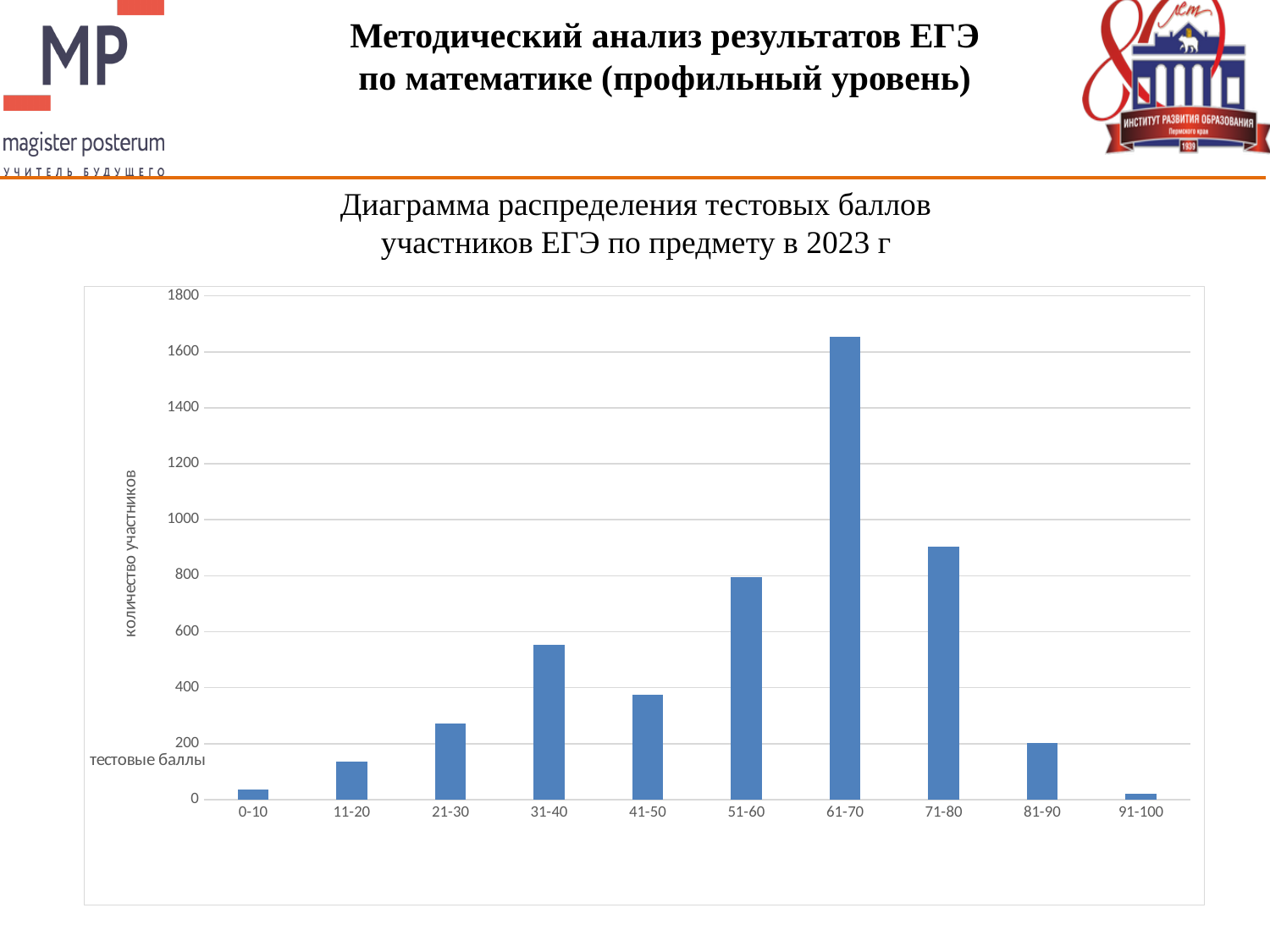
Which has more participants, 31-40 or 41-50? 31-40 Is the value for 71-80 greater or less than 1000? less Which score range has the highest number of participants? 61-70 What kind of chart is shown on the slide? bar chart Is the value for 61-70 greater or less than 1600? greater Which score range has the lowest number of participants? 91-100 Is the value for 41-50 greater or less than 400? less Which has more participants, 71-80 or 51-60? 71-80 What is the label of the vertical axis? количество участников How many score ranges (categories) are shown on the x axis? 10